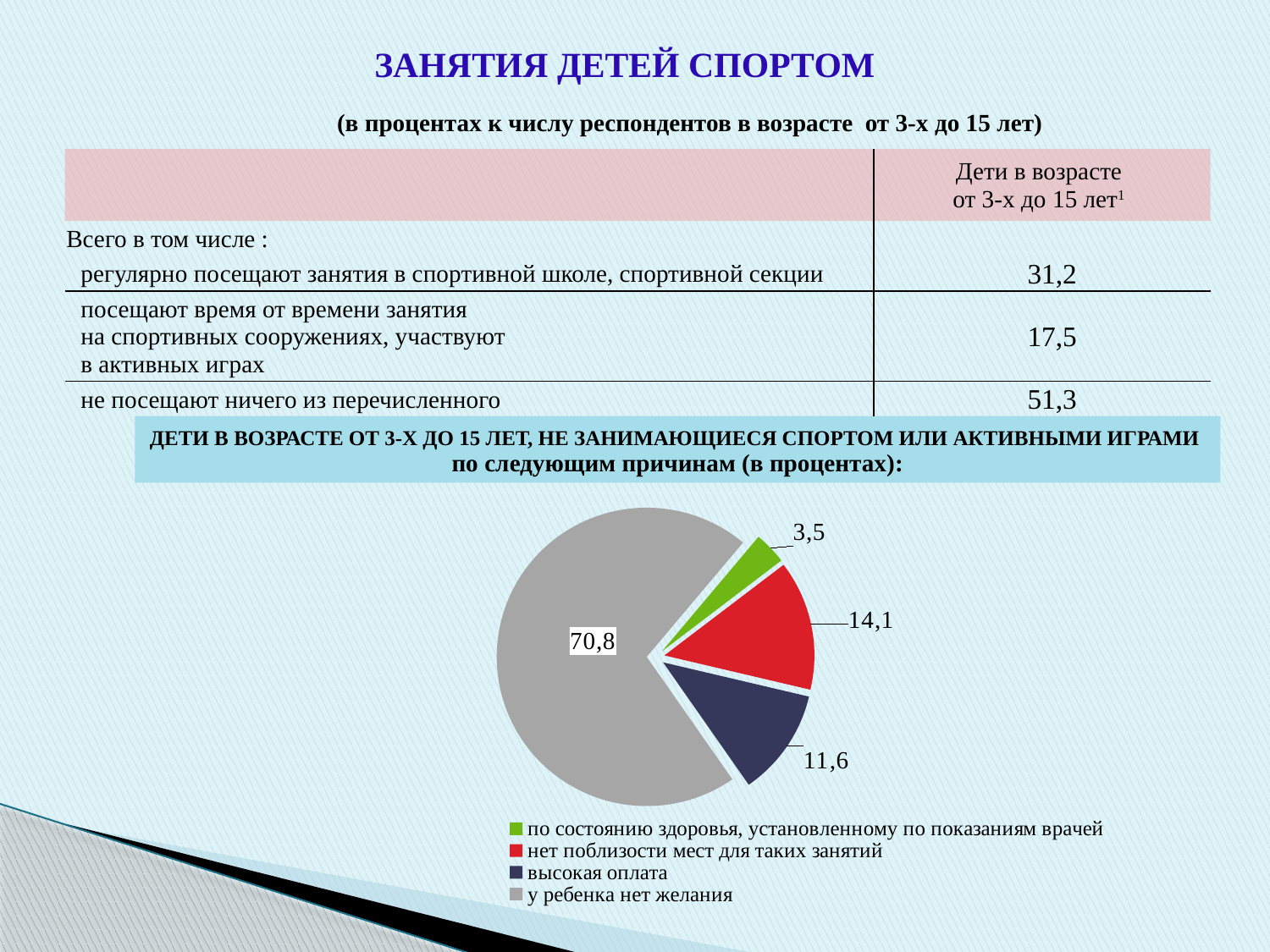
What is the value for "нет поблизости мест для таких занятий" in the pie chart? 14,1 What colour is the slice for "у ребенка нет желания"? grey Which is larger: the slice for "высокая оплата" or the slice for "нет поблизости мест для таких занятий"? нет поблизости мест для таких занятий What is the value for "по состоянию здоровья, установленному по показаниям врачей" in the pie chart? 3,5 What is the difference between the values for "нет поблизости мест для таких занятий" and "высокая оплата"? 2,5 How many entries does the pie chart legend list? 4 What is the value for "у ребенка нет желания" in the pie chart? 70,8 What kind of chart is shown on the slide? pie chart Which reason has the largest slice in the pie chart? у ребенка нет желания What is the value for "высокая оплата" in the pie chart? 11,6 Which reason has the smallest slice in the pie chart? по состоянию здоровья, установленному по показаниям врачей How many slices does the pie chart have? 4